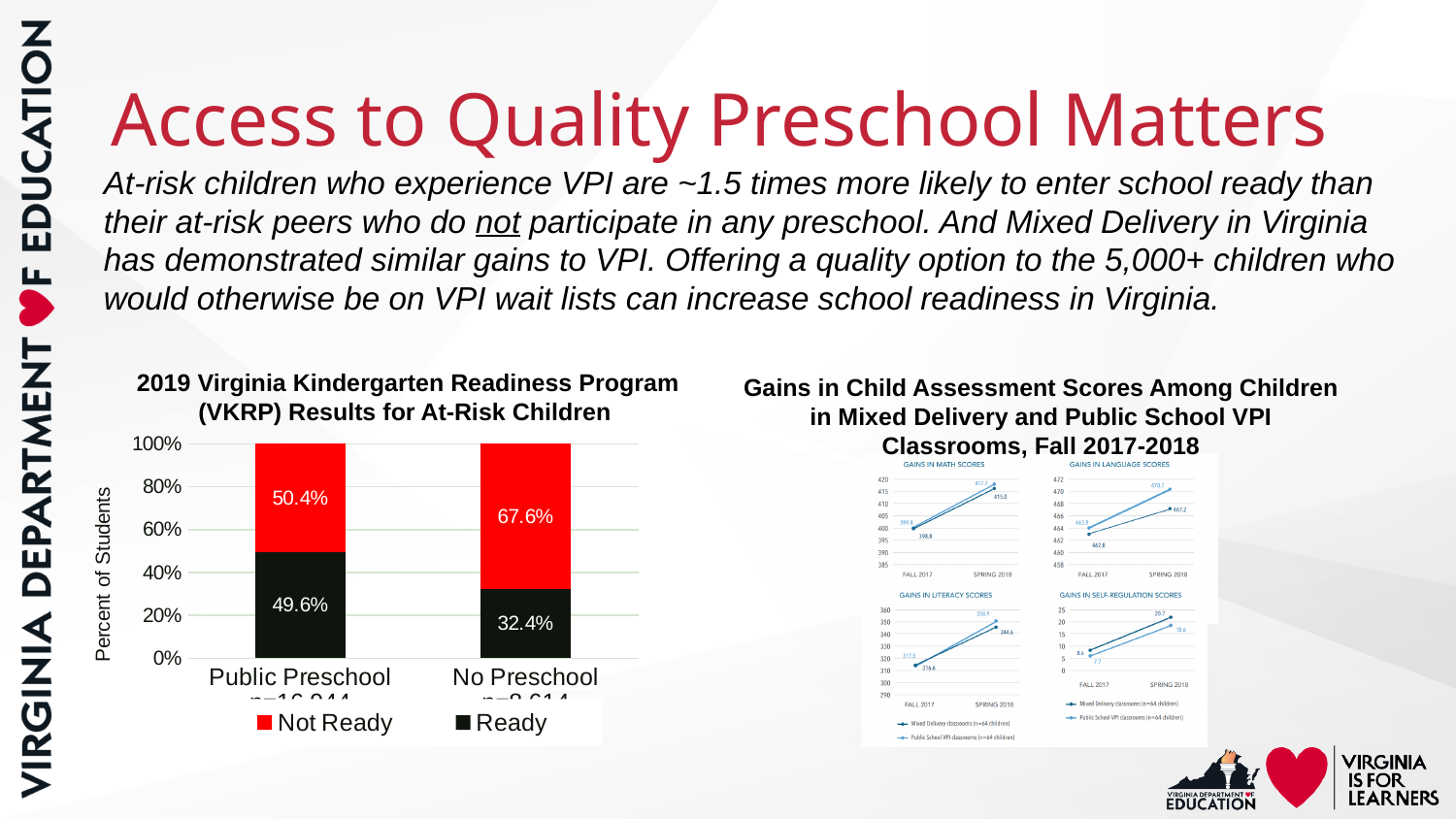
In the 2019 VKRP Results chart, what percentage of at-risk children in Public Preschool were Ready? 49.6% In the 2019 VKRP Results chart, what is the Ready percentage for No Preschool? 32.4% In the 2019 VKRP Results chart, what is the Not Ready percentage for Public Preschool? 50.4% In the 2019 VKRP Results chart, what percentage of at-risk children with No Preschool were Not Ready? 67.6% In the 2019 VKRP Results chart, what is the difference between the Ready percentages for Public Preschool and No Preschool? 17.2% In the 2019 VKRP Results chart, which category has the higher Ready percentage, Public Preschool or No Preschool? Public Preschool In the 2019 VKRP Results chart, what is the difference between the Not Ready percentages for No Preschool and Public Preschool? 17.2% In the 2019 VKRP Results chart, which colour represents Not Ready? Red In the 2019 VKRP Results chart, what is the total of the stacked bar for No Preschool? 100% How many series does the legend of the 2019 VKRP Results chart list? 2 What kind of chart is the 2019 VKRP Results chart? Stacked bar chart What is the y-axis label of the 2019 VKRP Results chart? Percent of Students